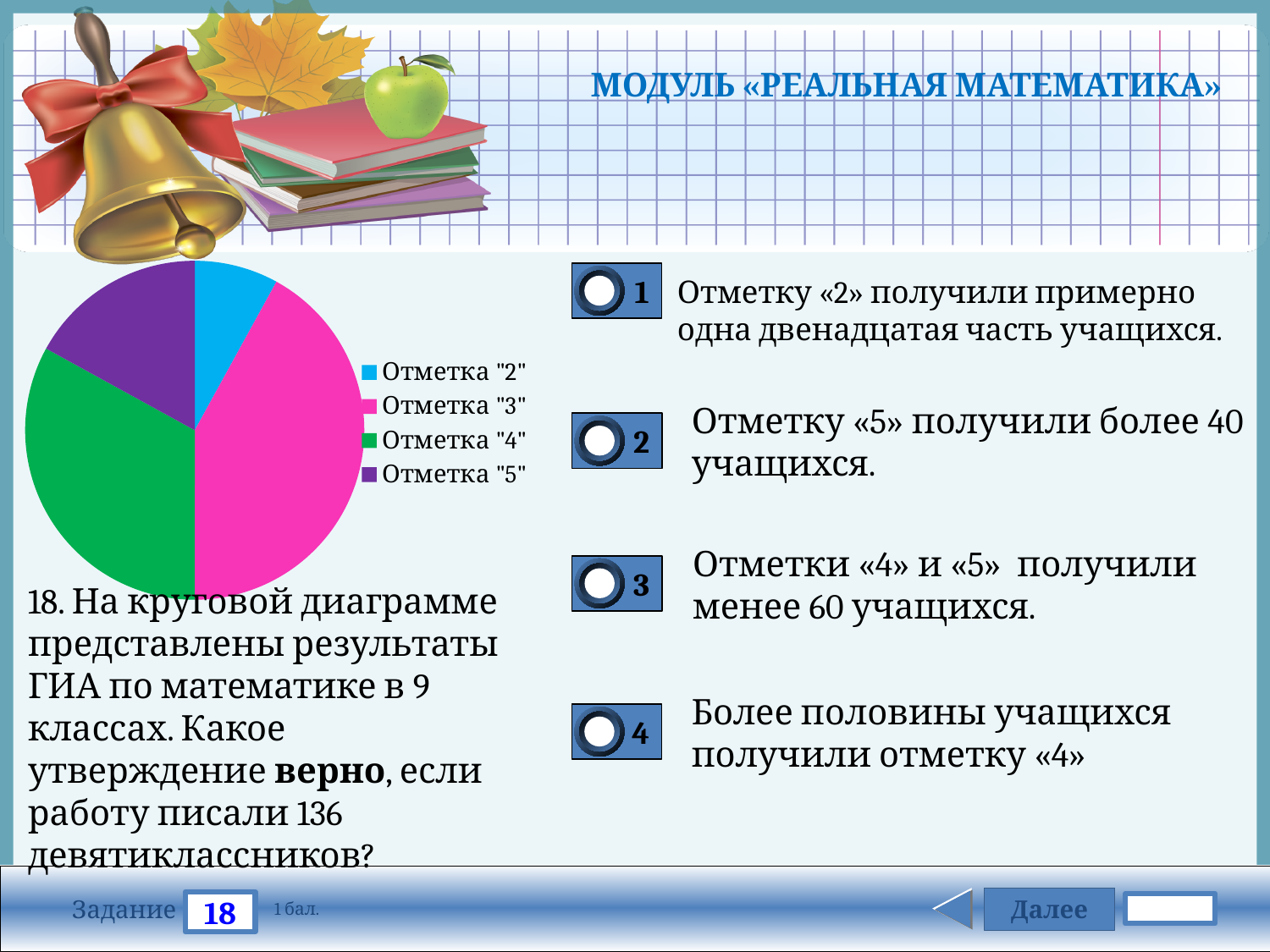
Which slice is larger in the pie chart: Отметка "4" or Отметка "5"? Отметка "4" What kind of chart is shown on the slide? pie chart What colour is the slice for Отметка "4" in the pie chart? green Which category is shown in purple in the pie chart? Отметка "5" How many entries does the legend of the pie chart list? 4 Which slice is larger in the pie chart: Отметка "2" or Отметка "5"? Отметка "5" How many slices does the pie chart have? 4 Which category has the largest slice in the pie chart? Отметка "3" Which category has the smallest slice in the pie chart? Отметка "2" Which slice is larger in the pie chart: Отметка "3" or Отметка "4"? Отметка "3"